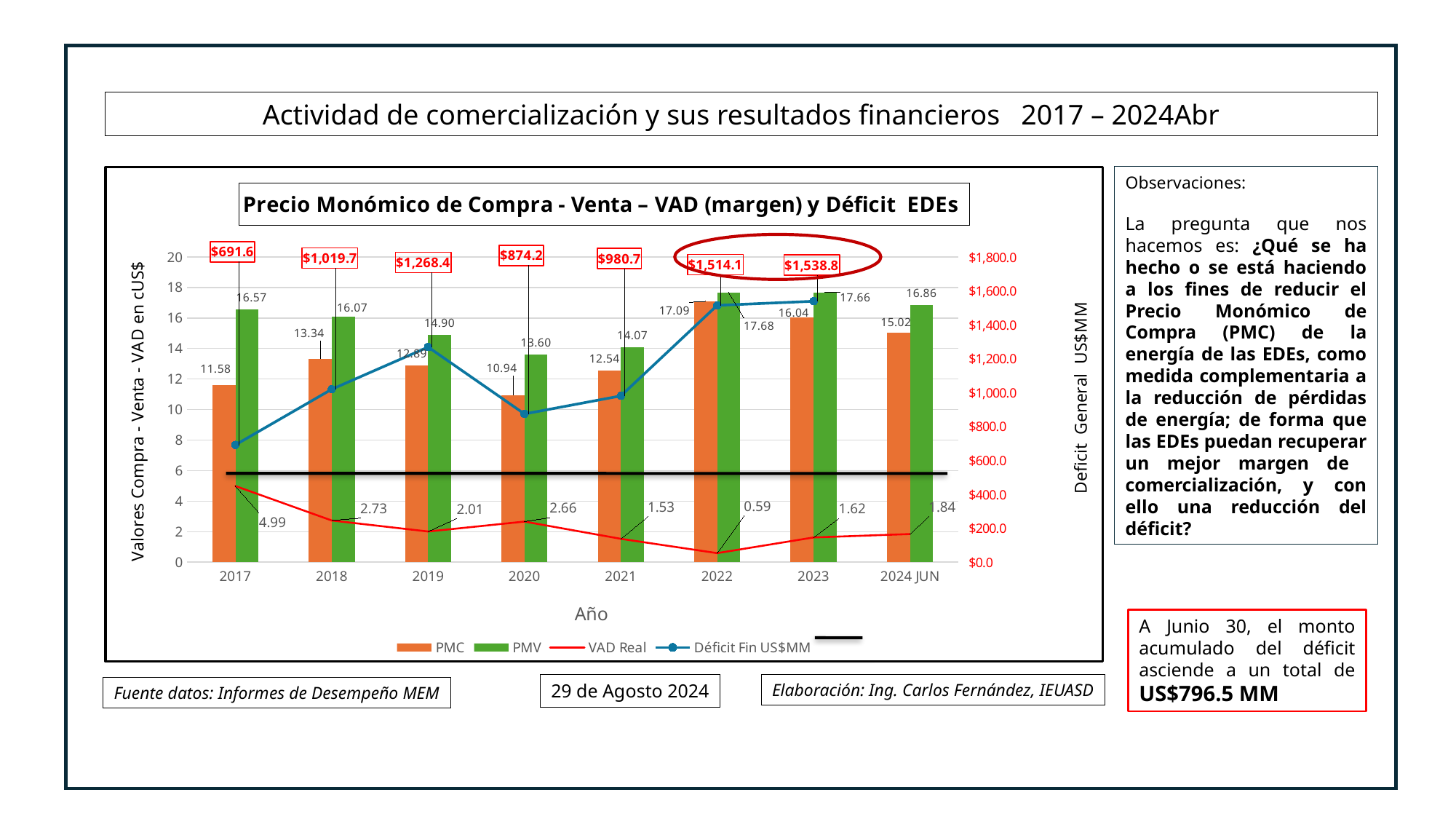
Does the Déficit Fin US$MM rise or fall from 2017 to 2019? rise What is the PMC value for 2017? 11.58 How many years (categories) are shown on the x axis? 8 What is the difference between the PMV and PMC values in 2022? 0.59 In which year is the PMC value lowest? 2020 In which year is the VAD Real value lowest? 2022 What is the PMV value for 2022? 17.68 Which year has the larger PMC value, 2018 or 2019? 2018 In which year is the Déficit Fin US$MM highest? 2023 What is the Déficit Fin US$MM value for 2023? $1,538.8 In which year is the VAD Real value highest? 2017 What is the VAD Real value for 2022? 0.59